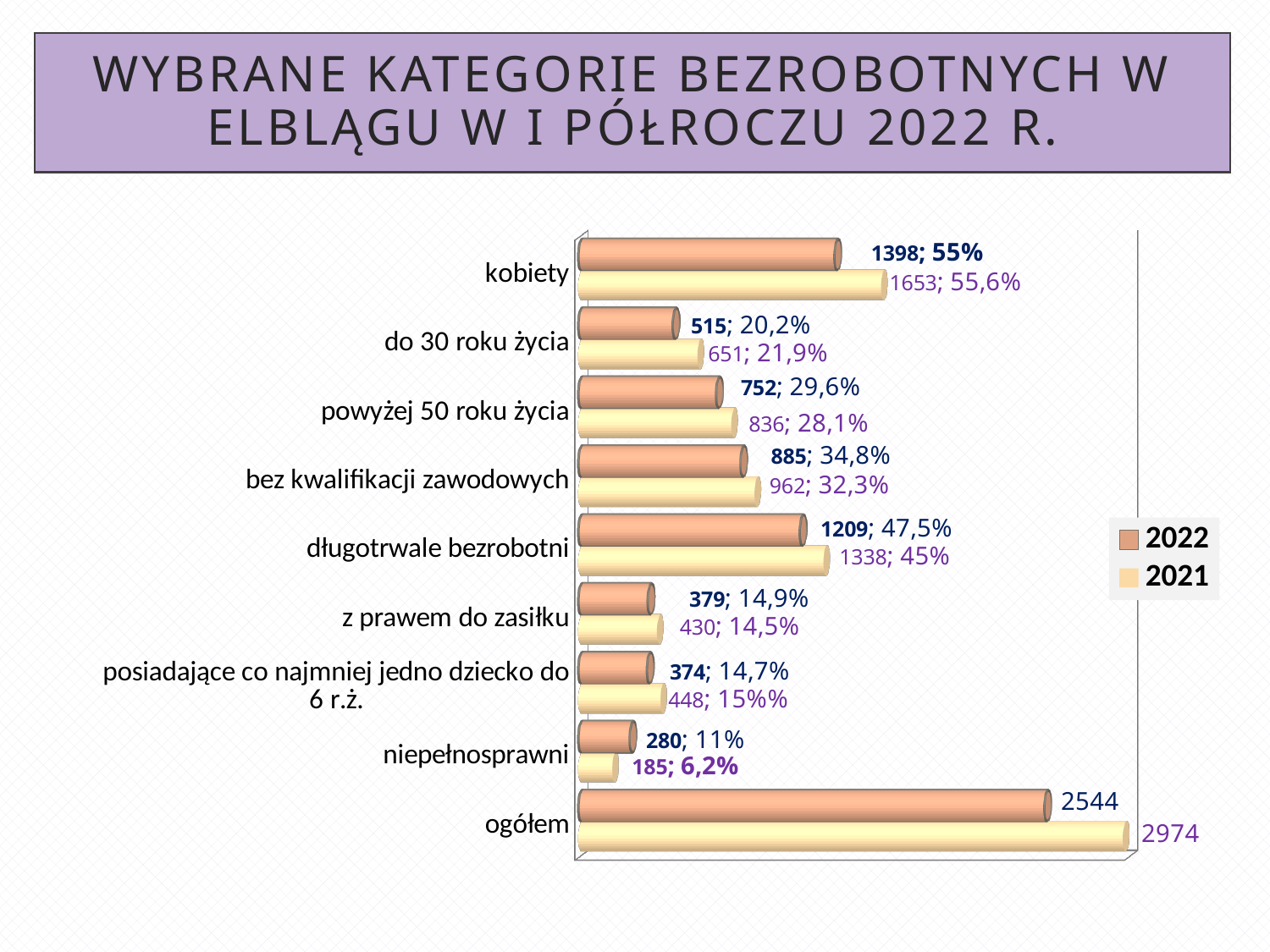
What type of chart is shown on the slide? bar chart What is the 2021 value for 'długotrwale bezrobotni'? 1338; 45% What is the 2022 value for 'niepełnosprawni'? 280; 11% How many categories are shown on the chart? 9 Which category has the highest 2022 value? ogółem Which category has the lowest 2021 value? niepełnosprawni What is the 2022 value for 'kobiety'? 1398; 55% Which series is shown in the lighter yellow colour? 2021 What is the difference between the 2021 and 2022 values for 'ogółem'? 430 For 'niepełnosprawni', which is larger: the 2022 value or the 2021 value? 2022 What is the 2021 value for 'ogółem'? 2974 How many series does the legend list? 2